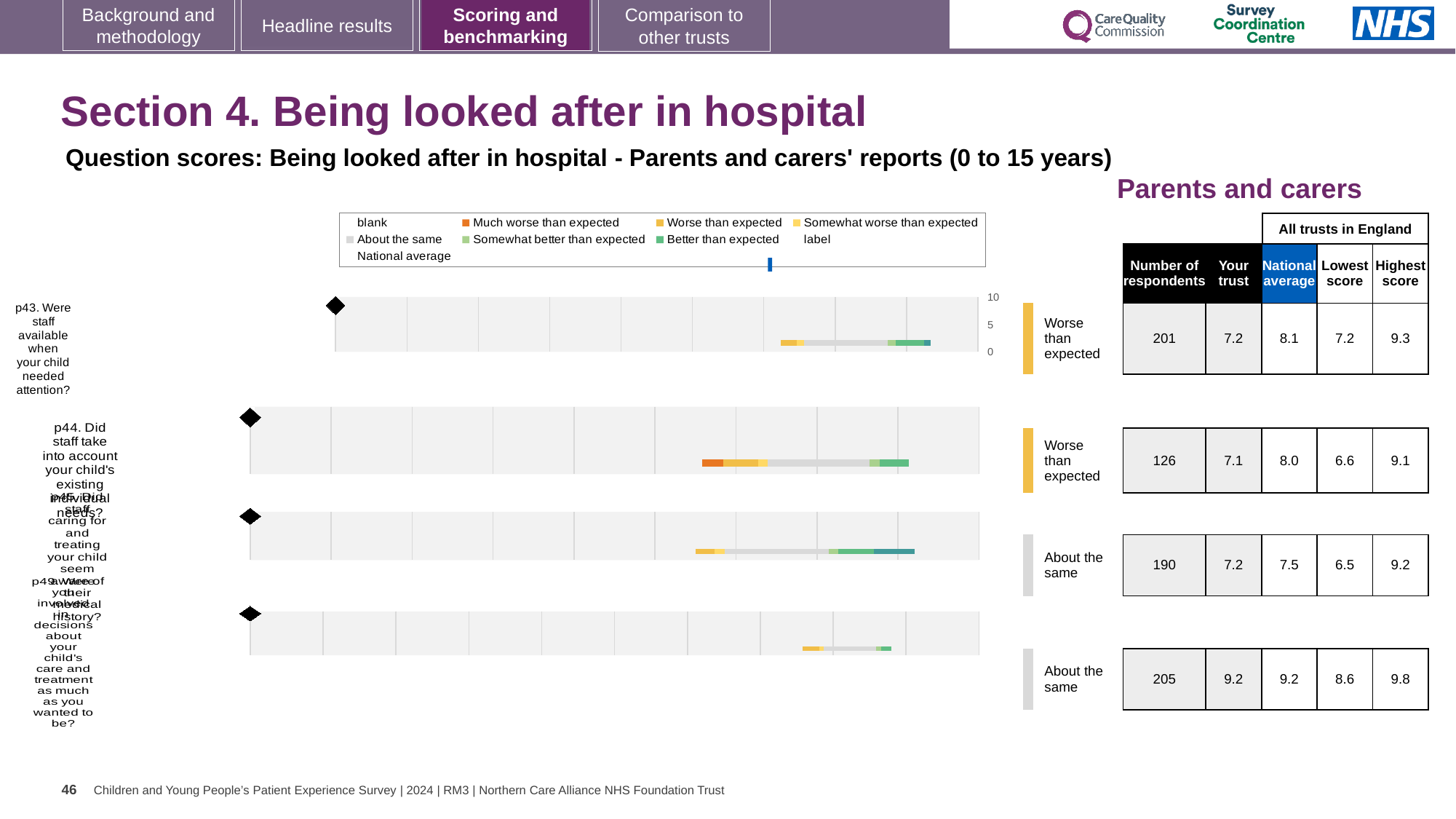
What is the 'Your trust' score for p43 (Were staff available when your child needed attention?)? 7.2 What is the national average for p43 (Were staff available when your child needed attention?)? 8.1 What is the number of respondents for p43 (Were staff available when your child needed attention?)? 201 Is the trust score for p43 larger or smaller than the national average for p43? smaller What is the highest score across all trusts in England for the bottom row (p49)? 9.8 Which row has the lowest number of respondents? p44 (second row), 126 Which row has the highest number of respondents? p49 (bottom row), 205 What benchmark category is shown for p43 (Were staff available when your child needed attention?)? Worse than expected What is the difference between the national average and the trust score for p43? 0.9 What kind of chart is used to show the question scores on this slide? bar chart What benchmark category is shown for the bottom row (p49)? About the same How many survey questions (rows) are plotted in the chart? 4